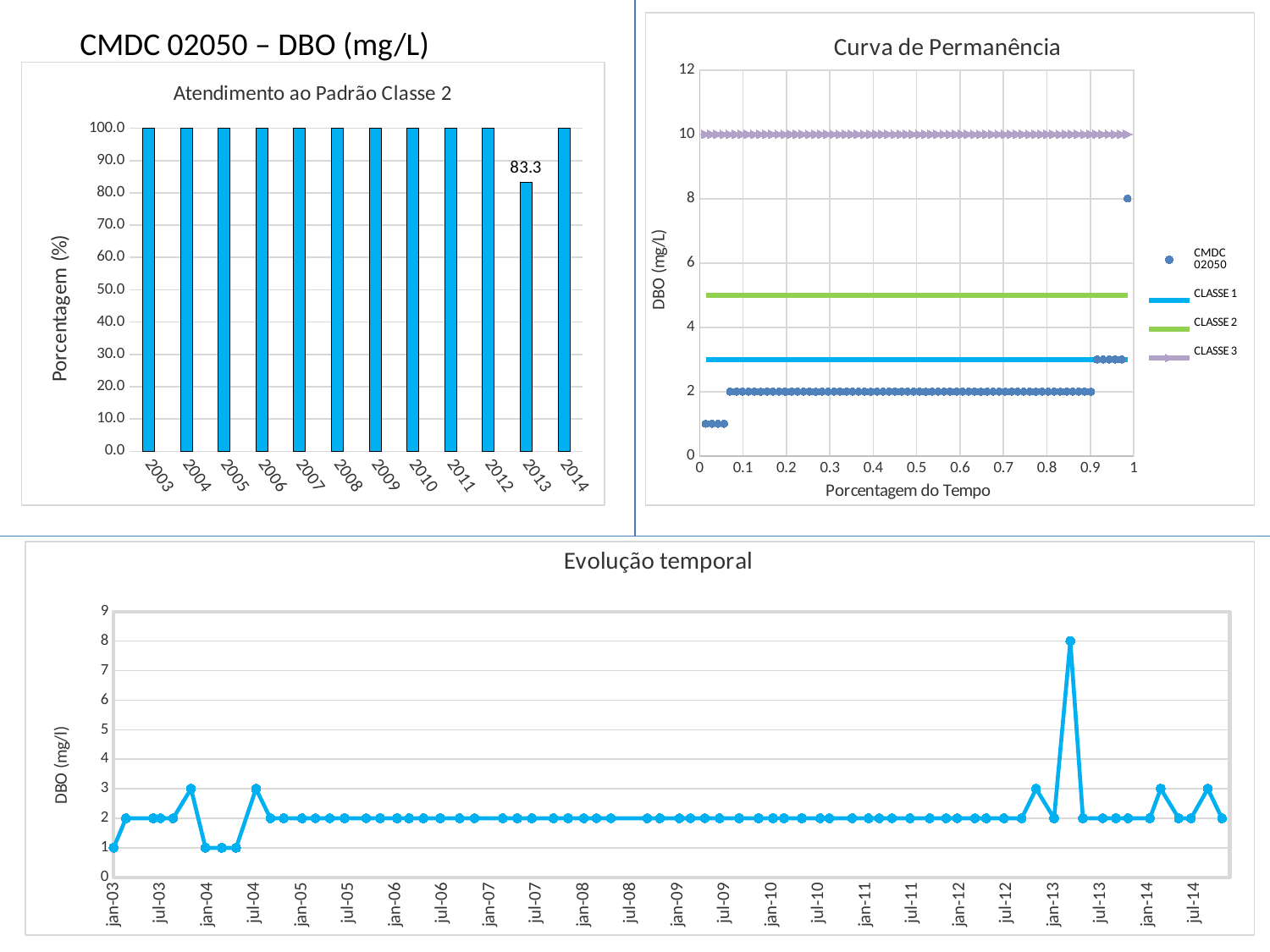
In the 'Atendimento ao Padrão Classe 2' chart, what is the value for 2013? 83.3 What kind of chart is 'Atendimento ao Padrão Classe 2'? Bar chart In the 'Atendimento ao Padrão Classe 2' chart, what is the difference between the values for 2012 and 2013? 16.7 How many years are shown on the x axis of the 'Atendimento ao Padrão Classe 2' chart? 12 In the 'Curva de Permanência' chart, is the CLASSE 2 line above or below the CLASSE 1 line? above In the 'Atendimento ao Padrão Classe 2' chart, is the value for 2013 greater or less than 90.0? less In the 'Atendimento ao Padrão Classe 2' chart, what is the value for 2008? 100.0 How many series does the legend of the 'Curva de Permanência' chart list? 4 In the 'Atendimento ao Padrão Classe 2' chart, which year has the lowest value? 2013 In the 'Evolução temporal' chart, what is the highest DBO (mg/l) value reached? 8 What is the y-axis label of the 'Evolução temporal' chart? DBO (mg/l) In the 'Curva de Permanência' chart, at what DBO (mg/L) value is the CLASSE 3 line drawn? 10